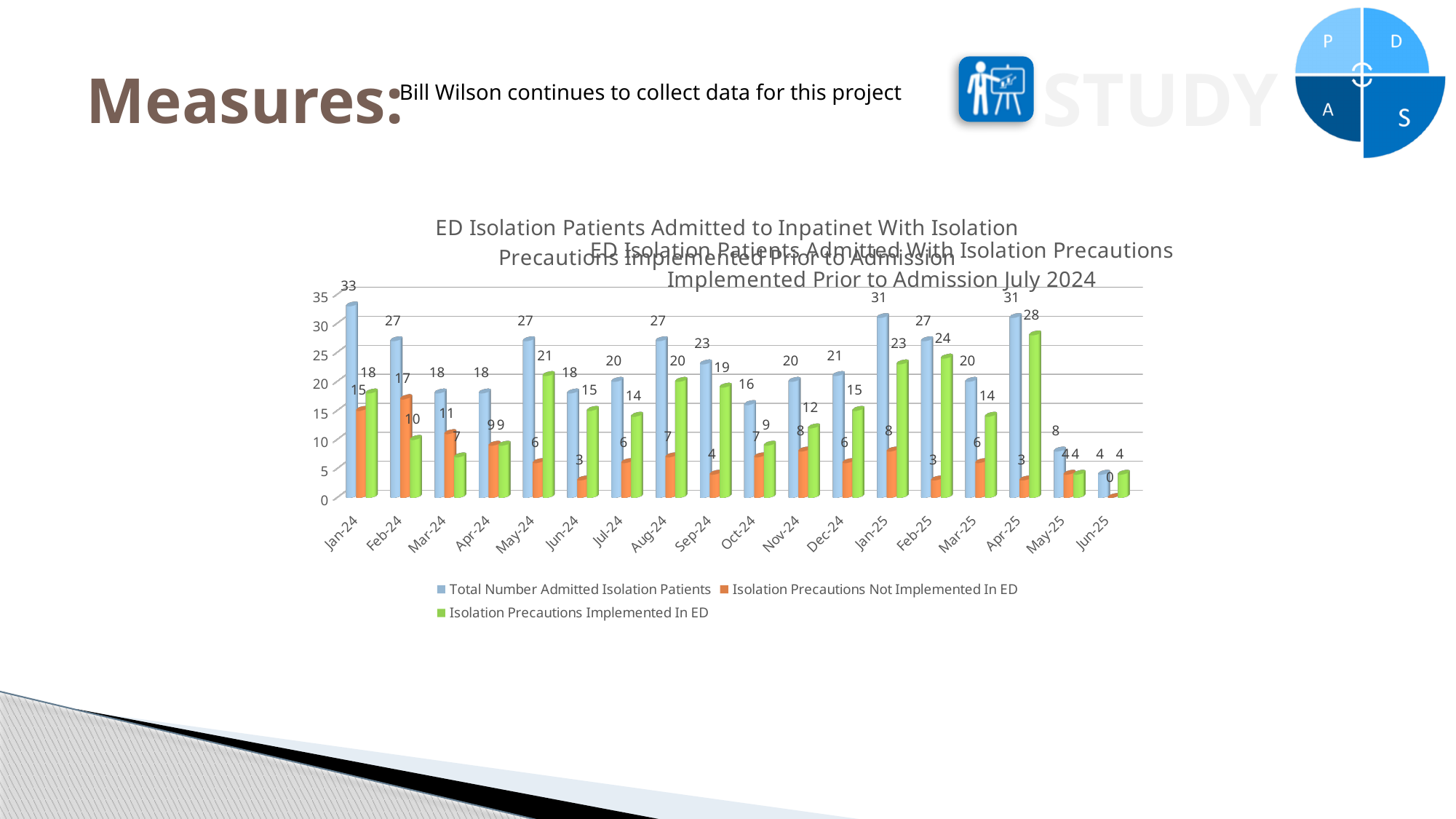
How many series does the chart legend list? 3 What colour are the bars for Isolation Precautions Implemented In ED? green What type of chart is shown on the slide? bar chart What is the value for Isolation Precautions Implemented In ED in Apr-25? 28 How many months are shown on the x axis of the chart? 18 What is the difference between Isolation Precautions Implemented In ED and Isolation Precautions Not Implemented In ED in May-24? 15 Which month has the lowest Total Number Admitted Isolation Patients? Jun-25 Which month has the highest value for Isolation Precautions Implemented In ED? Apr-25 Which month has the highest Total Number Admitted Isolation Patients? Jan-24 In Feb-24, which is larger: Isolation Precautions Not Implemented In ED or Isolation Precautions Implemented In ED? Isolation Precautions Not Implemented In ED What is the Total Number Admitted Isolation Patients for Jan-24? 33 What is the value for Isolation Precautions Not Implemented In ED in Feb-24? 17